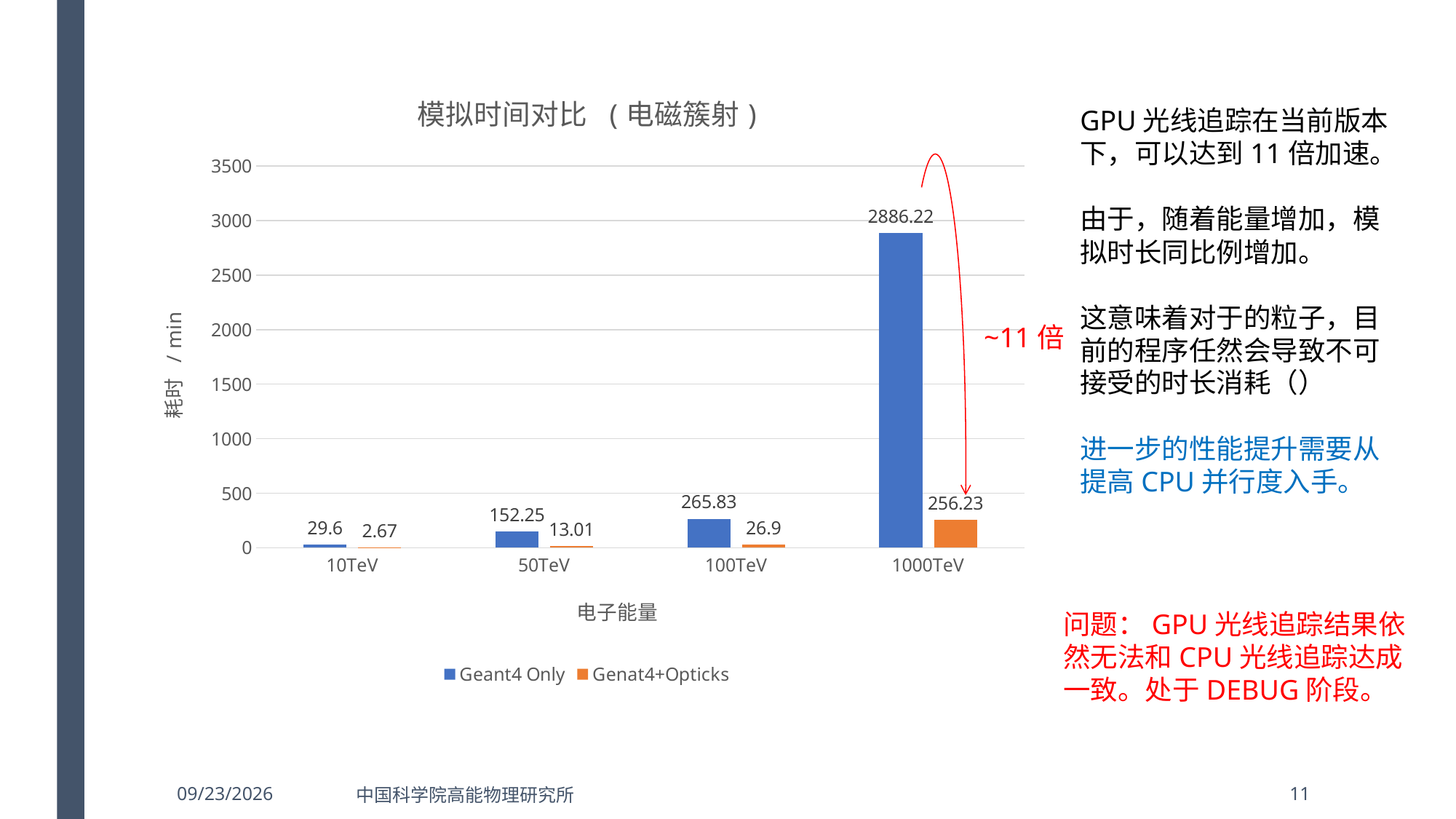
Which energy category has the lowest Genat4+Opticks value? 10TeV What kind of chart is shown? bar chart What is the value for Geant4 Only at 100TeV? 265.83 How many energy categories are shown on the x axis? 4 What is the value for Genat4+Opticks at 50TeV? 13.01 What is the difference between the Geant4 Only and Genat4+Opticks values at 1000TeV? 2629.99 Which energy category has the highest Geant4 Only value? 1000TeV What is the value for Genat4+Opticks at 10TeV? 2.67 What is the value for Geant4 Only at 1000TeV? 2886.22 Which is larger at 100TeV: Geant4 Only or Genat4+Opticks? Geant4 Only How many series does the legend list? 2 Do the Geant4 Only values rise or fall as energy increases along the x axis? rise